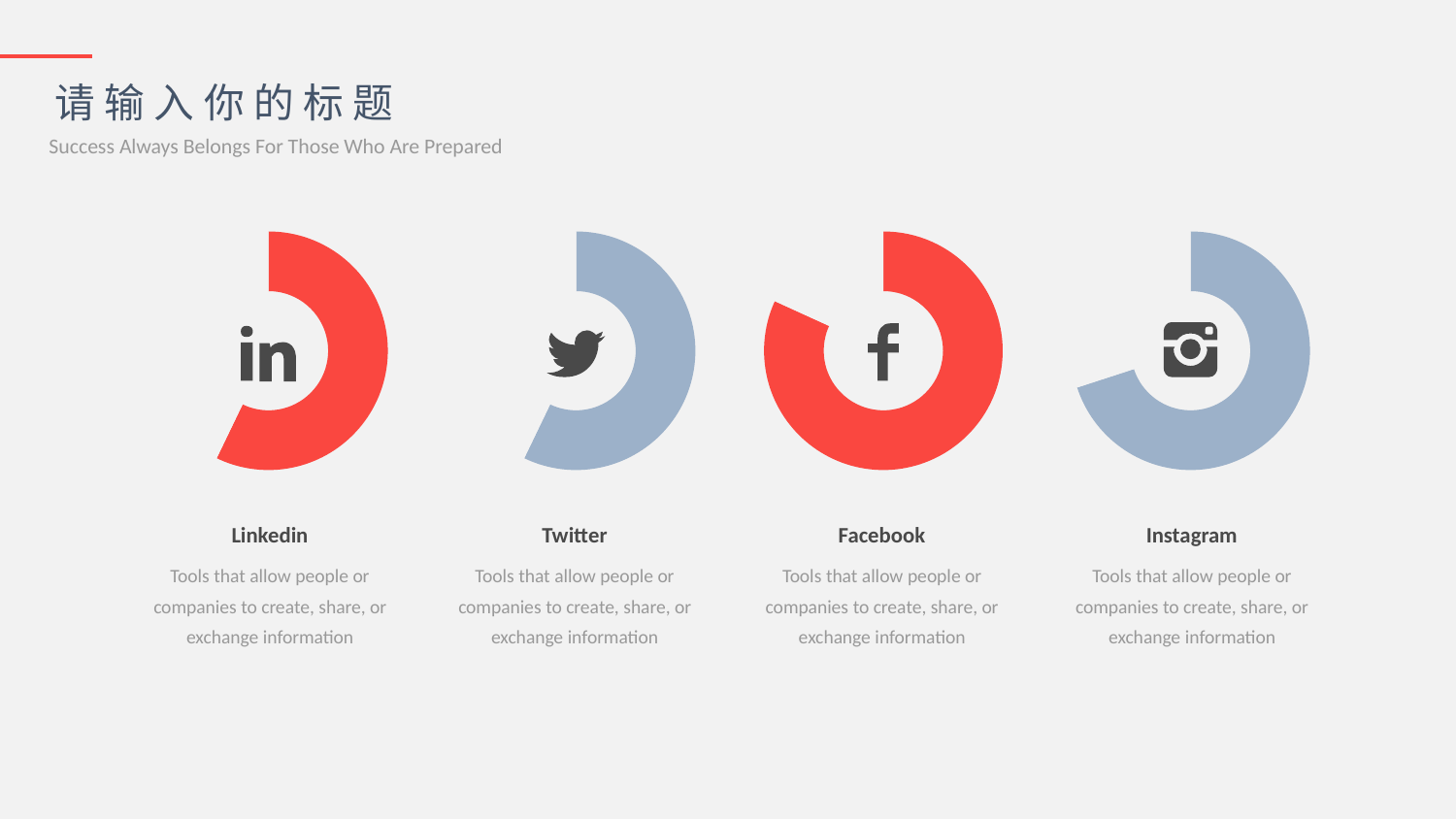
Which donut chart has the largest filled arc: Facebook or Linkedin? Facebook Which of the four donut charts has the largest filled portion? Facebook How many donut charts are shown on the slide? 4 What kind of chart is used for each of the four social media items on the slide? Donut chart Which social media platform is represented by the donut chart on the far left? Linkedin What colour is the filled arc of the Facebook donut chart? Red